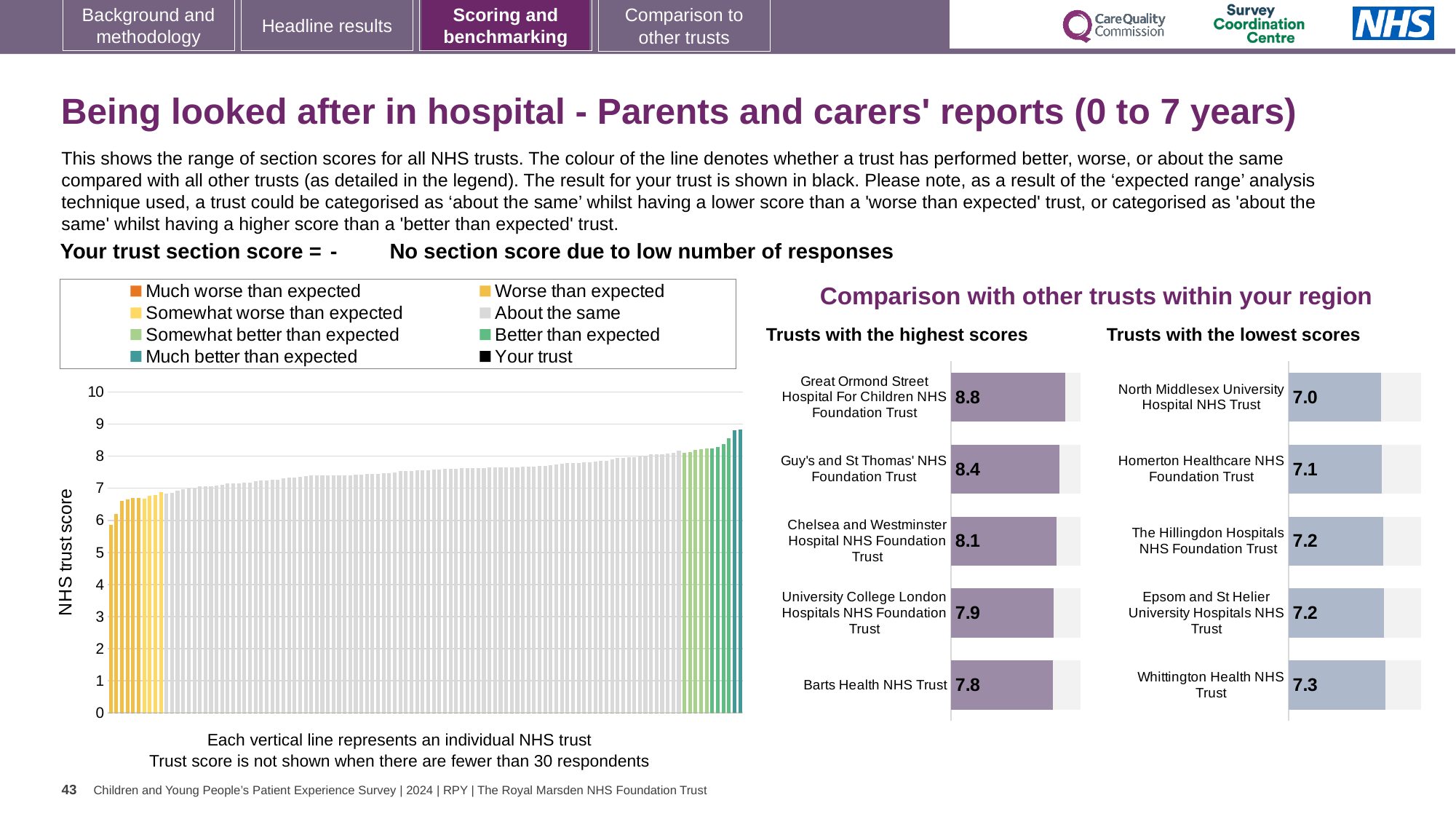
In the 'Trusts with the highest scores' chart, what is the score for Great Ormond Street Hospital For Children NHS Foundation Trust? 8.8 In the 'Trusts with the lowest scores' chart, which trust has the lowest score? North Middlesex University Hospital NHS Trust Which has a higher score: Chelsea and Westminster Hospital NHS Foundation Trust in the highest-scores chart or Whittington Health NHS Trust in the lowest-scores chart? Chelsea and Westminster Hospital NHS Foundation Trust In the 'Trusts with the lowest scores' chart, what is the score for Homerton Healthcare NHS Foundation Trust? 7.1 In the large 'NHS trust score' chart on the left, do the bar values rise or fall from left to right? rise In the 'Trusts with the highest scores' chart, what is the score for Barts Health NHS Trust? 7.8 In the 'Trusts with the highest scores' chart, which trust has the highest score? Great Ormond Street Hospital For Children NHS Foundation Trust How many entries does the legend above the large 'NHS trust score' chart list? 8 In the large 'NHS trust score' chart on the left, is the value of the leftmost (lowest) bar greater or less than 7? less How many trusts are shown in the 'Trusts with the lowest scores' chart? 5 In the 'Trusts with the lowest scores' chart, what is the difference between the scores of Whittington Health NHS Trust and North Middlesex University Hospital NHS Trust? 0.3 In the 'Trusts with the highest scores' chart, what is the difference between the scores of Great Ormond Street Hospital For Children NHS Foundation Trust and Guy's and St Thomas' NHS Foundation Trust? 0.4